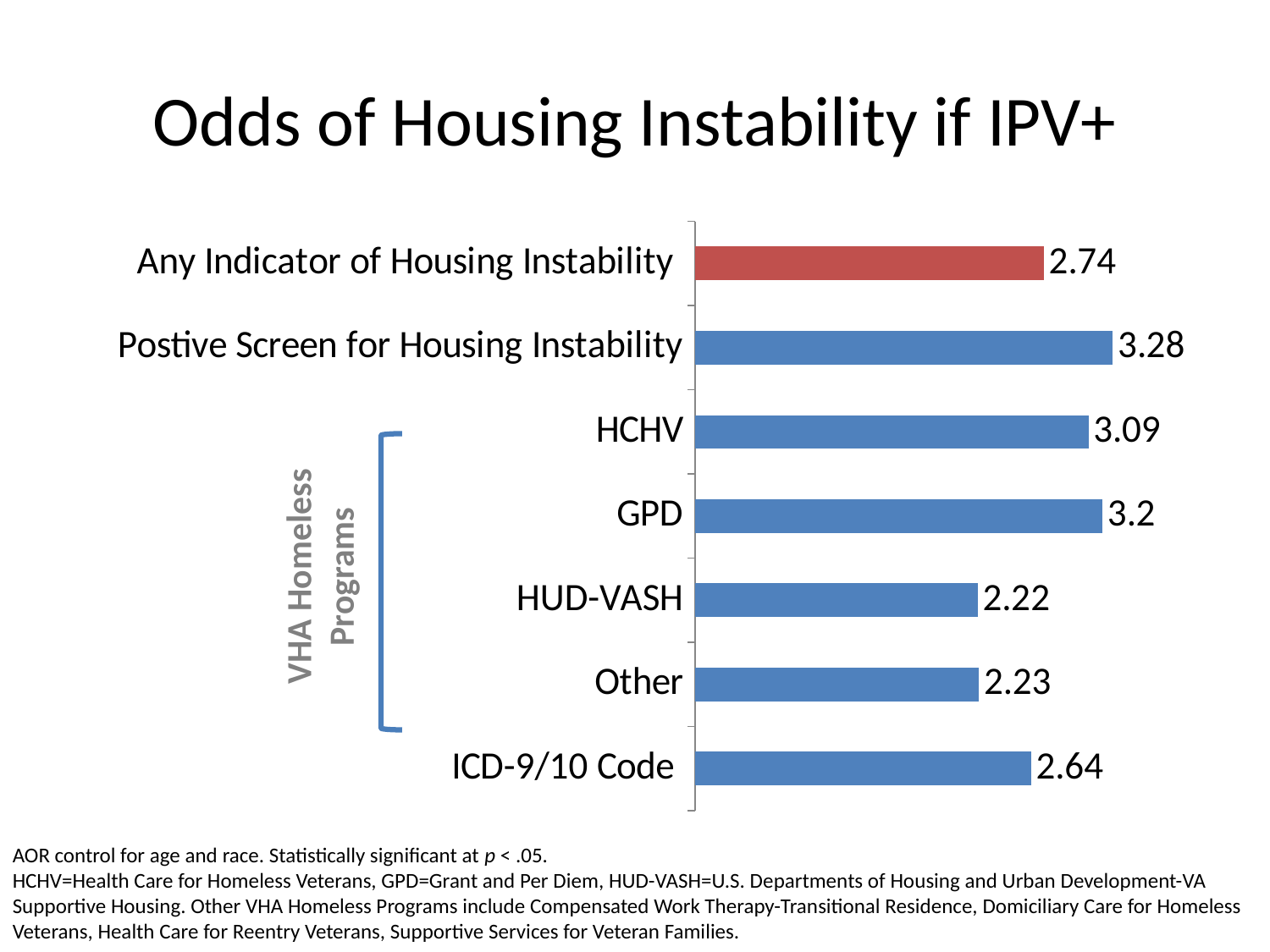
Which bar is coloured red rather than blue? Any Indicator of Housing Instability Which is larger, the value for HCHV or the value for ICD-9/10 Code? HCHV What kind of chart is shown on the slide? Bar chart How many categories are shown in the chart? 7 What is the odds value for ICD-9/10 Code? 2.64 What is the odds value for Any Indicator of Housing Instability? 2.74 What is the difference between the values for HCHV and HUD-VASH? 0.87 What is the difference between the values for Postive Screen for Housing Instability and Any Indicator of Housing Instability? 0.54 Which category has the highest odds value? Postive Screen for Housing Instability Which category has the lowest odds value? HUD-VASH What is the odds value for GPD? 3.2 What is the odds value for HUD-VASH? 2.22